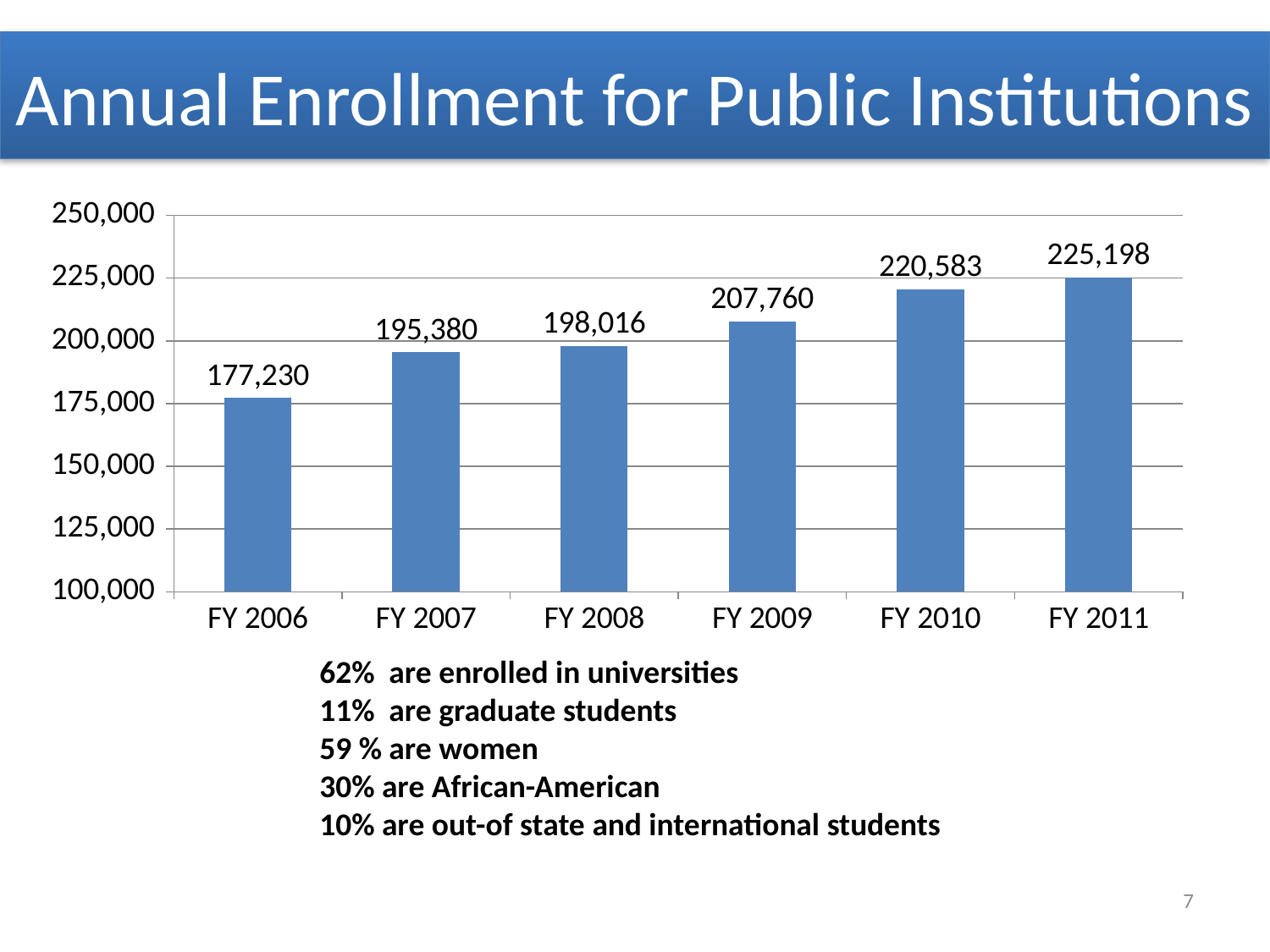
Which fiscal year has the highest enrollment? FY 2011 What is the enrollment value for FY 2010? 220,583 What kind of chart is shown on the slide? bar chart How many fiscal years are shown on the chart? 6 Which fiscal year has the lowest enrollment? FY 2006 What is the title of the slide containing the chart? Annual Enrollment for Public Institutions What is the difference in enrollment between FY 2011 and FY 2006? 47,968 What is the enrollment value for FY 2008? 198,016 Is the enrollment for FY 2010 greater or less than 200,000? greater What is the difference in enrollment between FY 2009 and FY 2008? 9,744 Do enrollment values rise or fall from FY 2006 to FY 2011? rise Which has a larger enrollment, FY 2007 or FY 2009? FY 2009